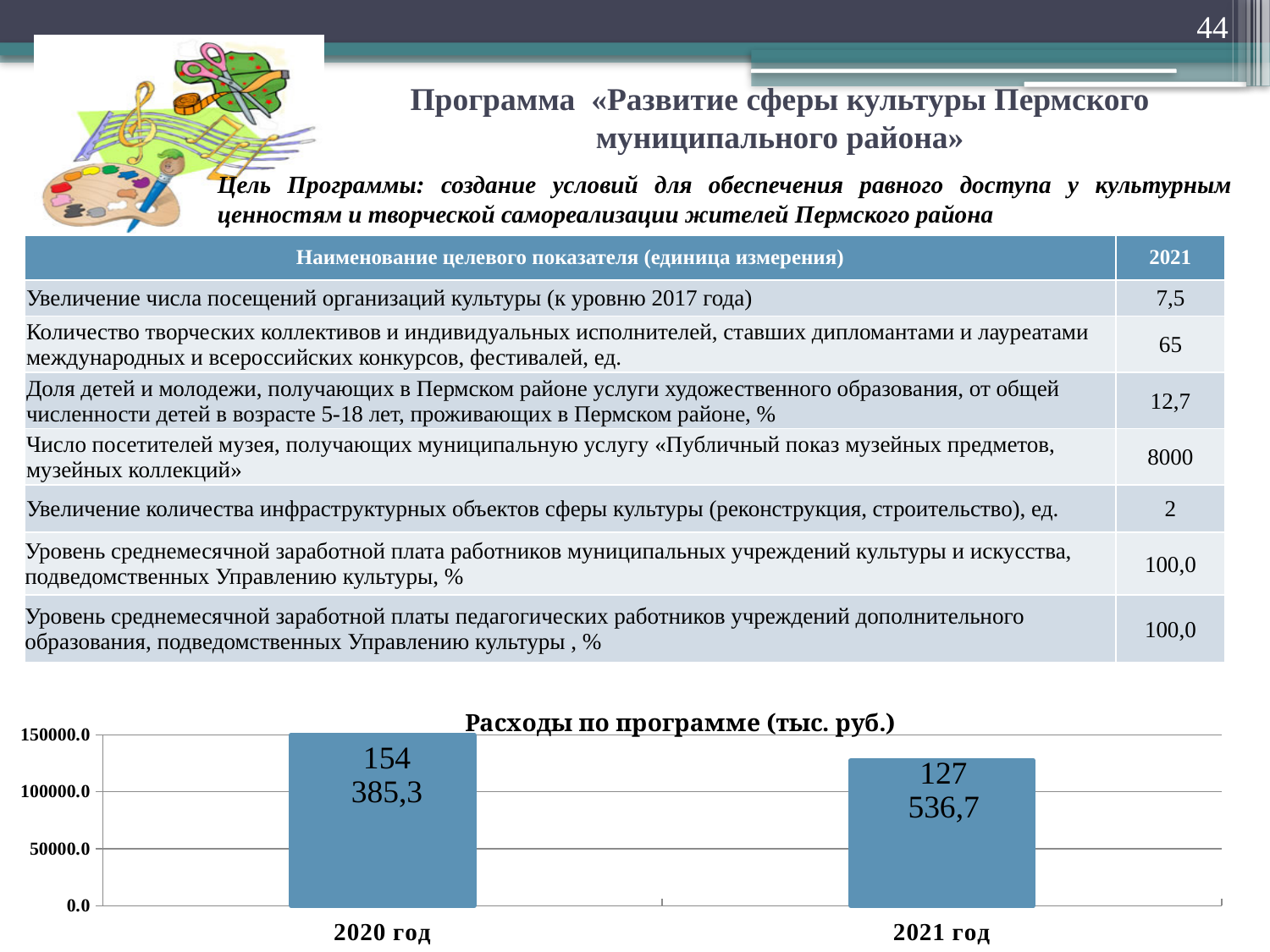
What is the value for "2021 год" in the chart "Расходы по программе (тыс. руб.)"? 127 536,7 In the chart "Расходы по программе (тыс. руб.)", what is the difference between the values for "2020 год" and "2021 год"? 26 848,6 How many bars are plotted in the chart "Расходы по программе (тыс. руб.)"? 2 What is the title of the bar chart at the bottom of the slide? Расходы по программе (тыс. руб.) In the chart "Расходы по программе (тыс. руб.)", is the value for "2020 год" greater or less than 150000.0? greater In the chart "Расходы по программе (тыс. руб.)", is the value for "2021 год" greater or less than 100000.0? greater What is the value for "2020 год" in the chart "Расходы по программе (тыс. руб.)"? 154 385,3 What type of chart is shown under the title "Расходы по программе (тыс. руб.)"? bar chart Which category has the highest value in the chart "Расходы по программе (тыс. руб.)"? 2020 год Do the values in the chart "Расходы по программе (тыс. руб.)" rise or fall from "2020 год" to "2021 год"? fall In the chart "Расходы по программе (тыс. руб.)", which is larger: the value for "2020 год" or for "2021 год"? 2020 год Which category has the lowest value in the chart "Расходы по программе (тыс. руб.)"? 2021 год